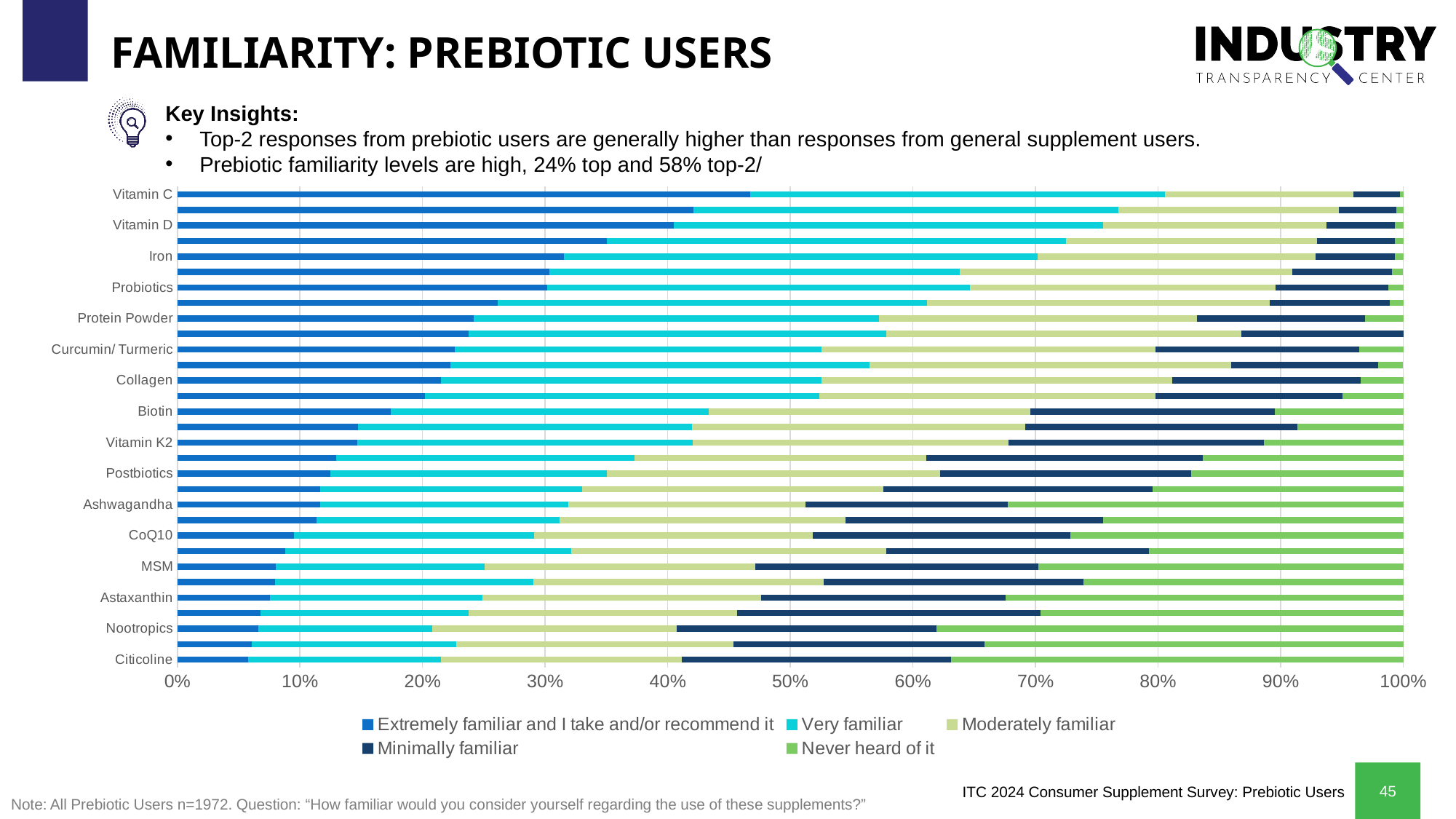
Moving down the chart from Vitamin C to Citicoline, does the 'Extremely familiar and I take and/or recommend it' segment rise or fall? fall Is the 'Extremely familiar and I take and/or recommend it' value for Biotin greater or less than 20%? less What kind of chart is shown on the slide? Stacked bar chart Is the 'Extremely familiar and I take and/or recommend it' value for Protein Powder greater or less than 20%? greater Which has a larger 'Extremely familiar and I take and/or recommend it' segment, Vitamin D or Biotin? Vitamin D How many series does the legend list? 5 Is the 'Extremely familiar and I take and/or recommend it' value for Citicoline greater or less than 10%? less Which category has the largest 'Extremely familiar and I take and/or recommend it' segment? Vitamin C Which legend entry is shown in dark navy? Minimally familiar What is the title of the slide containing the chart? FAMILIARITY: PREBIOTIC USERS